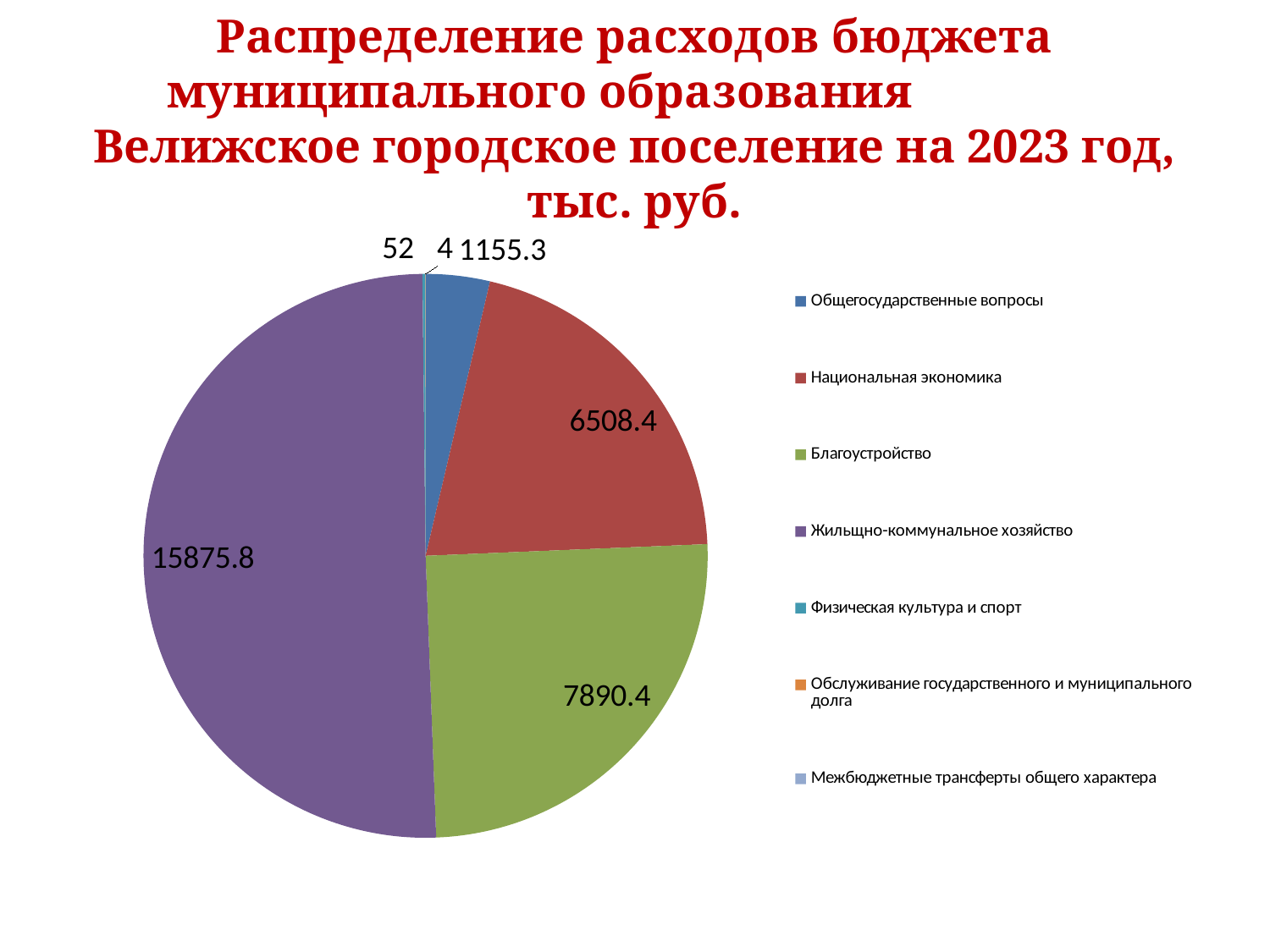
What colour is the slice for Жилищно-коммунальное хозяйство? purple What is the difference between the values for Жилищно-коммунальное хозяйство and Благоустройство? 7985.4 What is the value for Национальная экономика? 6508.4 What is the value for Общегосударственные вопросы? 1155.3 Which is larger, Благоустройство or Национальная экономика? Благоустройство What kind of chart is shown on the slide? pie chart How many categories does the legend list? 7 What is the value for Жилищно-коммунальное хозяйство? 15875.8 In what units are the values on the chart given, according to the title? тыс. руб. What is the value for Благоустройство? 7890.4 Which category has the largest slice of the pie? Жилищно-коммунальное хозяйство What is the difference between the values for Благоустройство and Национальная экономика? 1382